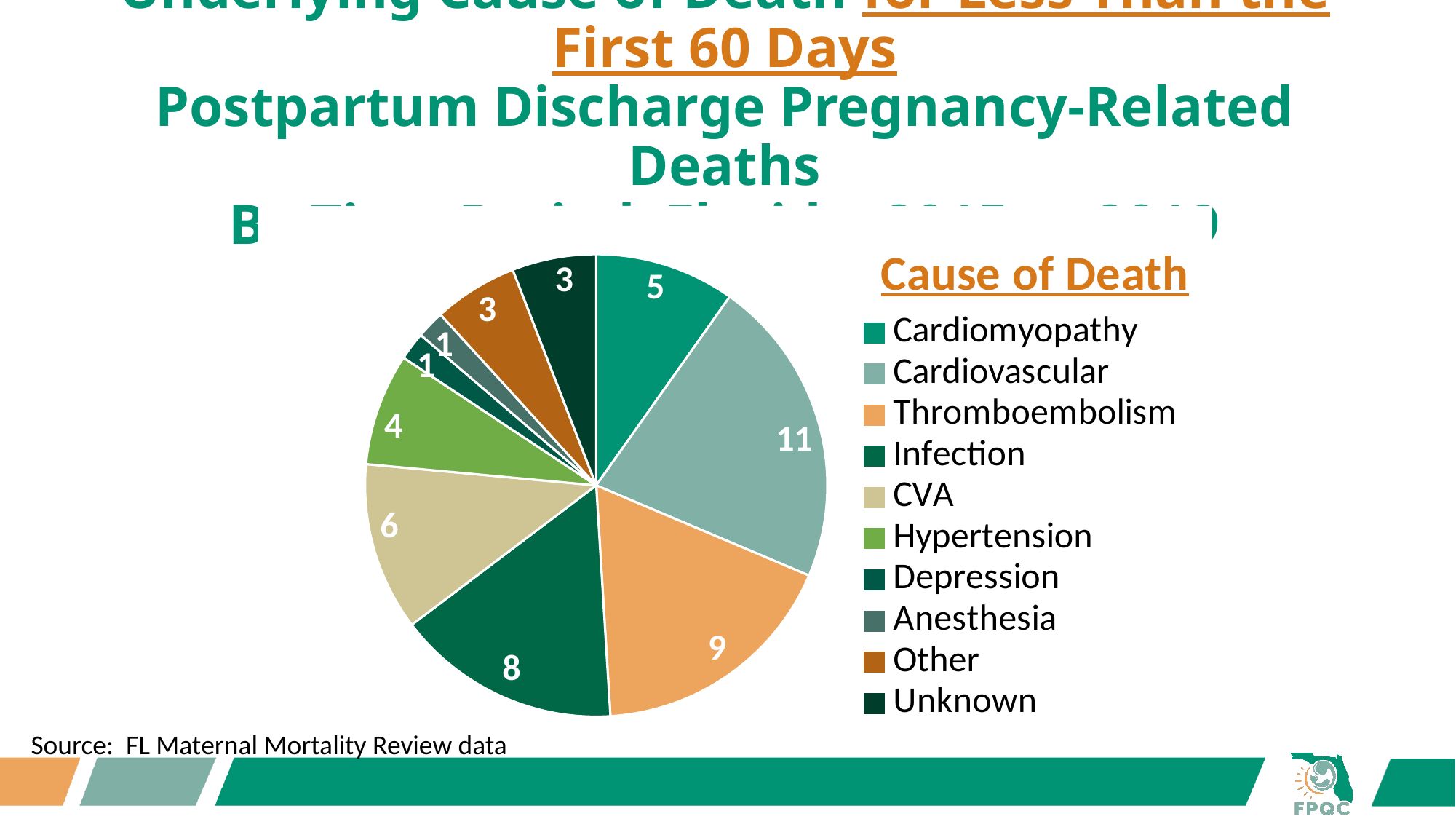
What type of chart is shown on the slide? Pie chart How many cause-of-death categories does the pie chart legend list? 10 What is the value shown for Cardiomyopathy in the pie chart? 5 Which is larger in the pie chart, the value for CVA or the value for Hypertension? CVA What is the title shown above the legend of the pie chart? Cause of Death What is the value shown for Thromboembolism in the pie chart? 9 What is the total of all the slice values in the pie chart? 51 What is the value shown for Infection in the pie chart? 8 What is the difference between the Cardiovascular and Cardiomyopathy values in the pie chart? 6 What is the value shown for Hypertension in the pie chart? 4 How many deaths are attributed to Cardiovascular causes in the pie chart? 11 Which cause of death has the largest slice in the pie chart? Cardiovascular